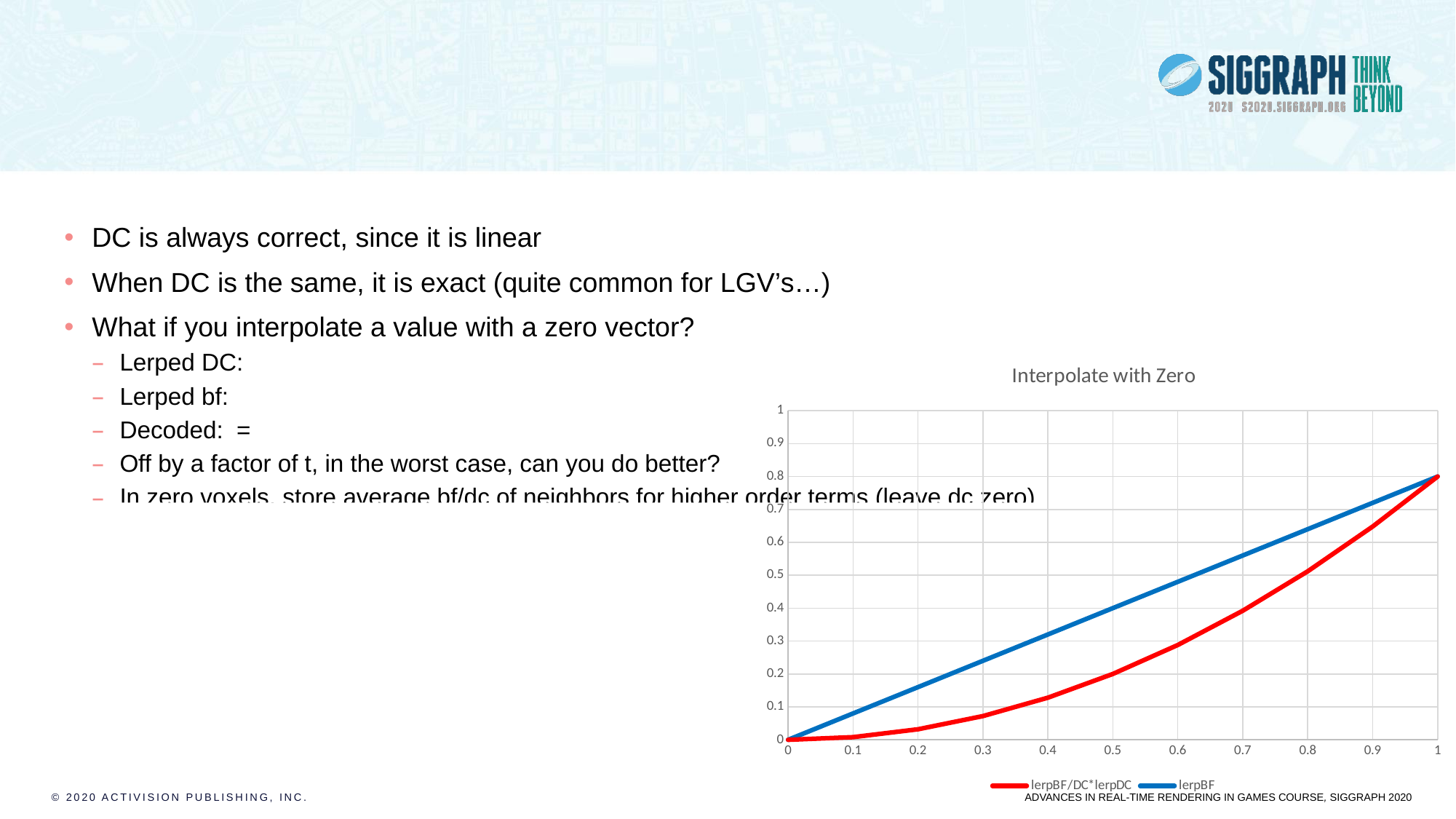
What is the title of the chart? Interpolate with Zero Which series is drawn in red in the chart? lerpBF/DC*lerpDC Do the values of the lerpBF/DC*lerpDC series rise or fall as x increases from 0 to 1? rise Is the value of the lerpBF/DC*lerpDC series at x = 0.3 greater or less than 0.1? less What is the value of the lerpBF series at x = 0? 0 At x = 0.5, which series has the larger value, lerpBF or lerpBF/DC*lerpDC? lerpBF How many series does the chart's legend list? 2 What kind of chart is shown on the slide? line chart Is the value of the lerpBF series at x = 0.8 greater or less than 0.6? greater Do the values of the lerpBF series rise or fall as x increases from 0 to 1? rise What is the value of the lerpBF series at x = 0.5? 0.4 What is the value of the lerpBF series at x = 1? 0.8